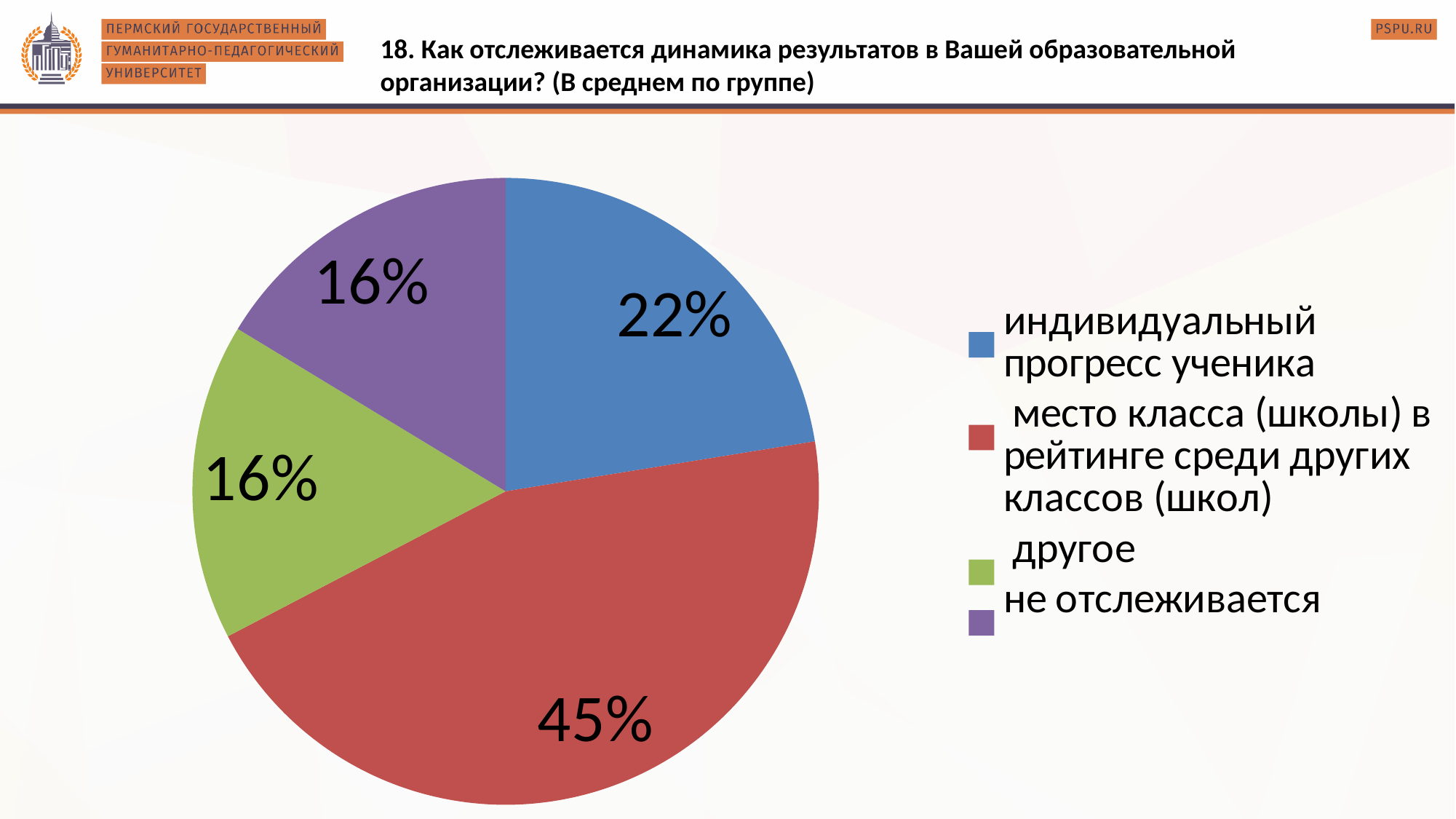
What type of chart is shown on the slide? pie chart What share of the pie is labelled "не отслеживается"? 16% How many slices does the pie chart have? 4 What share of the pie is labelled "индивидуальный прогресс ученика"? 22% What share of the pie is labelled "место класса (школы) в рейтинге среди других классов (школ)"? 45% What is the difference in percentage points between "место класса (школы) в рейтинге среди других классов (школ)" and "индивидуальный прогресс ученика"? 23 What colour is the slice for "место класса (школы) в рейтинге среди других классов (школ)"? red What share of the pie is labelled "другое"? 16% How many entries does the legend list? 4 Which is larger: the slice for "индивидуальный прогресс ученика" or the slice for "другое"? индивидуальный прогресс ученика Which category has the largest slice of the pie? место класса (школы) в рейтинге среди других классов (школ) What colour is the slice for "не отслеживается"? purple